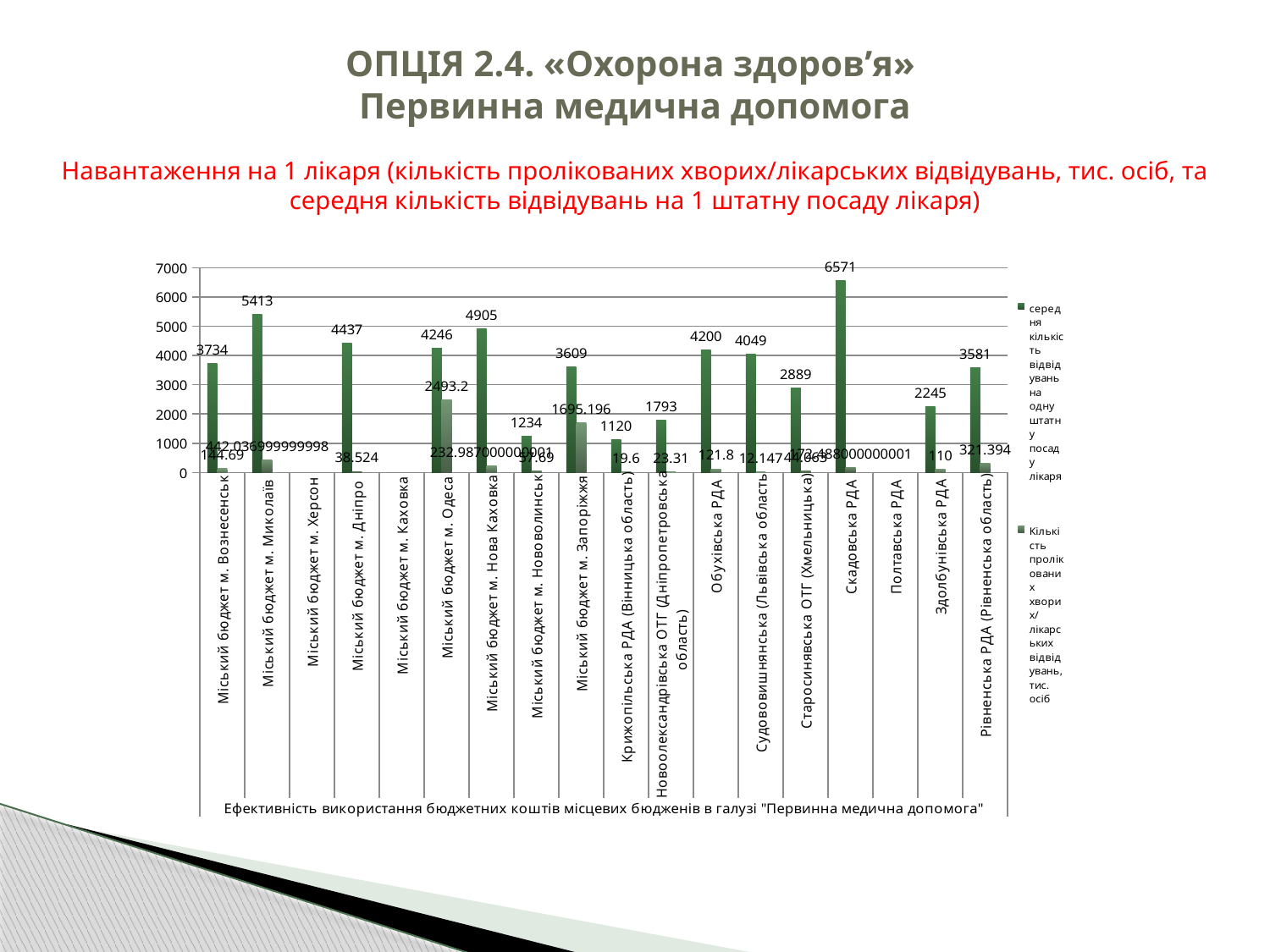
Which has a higher average number of visits per doctor position: Міський бюджет м. Дніпро or Міський бюджет м. Одеса? Міський бюджет м. Дніпро What type of chart is shown on the slide? Bar chart What is the difference between the average visits per doctor position for Міський бюджет м. Миколаїв and Міський бюджет м. Вознесенськ? 1679 What is the average number of visits per staff doctor position for Міський бюджет м. Нова Каховка? 4905 What is the average number of visits per staff doctor position for Здолбунівська РДА? 2245 Is the average number of visits per doctor position for Міський бюджет м. Запоріжжя greater or less than 3000? greater Which category has the highest average number of visits per staff doctor position? Скадовська РДА What is the average number of visits per staff doctor position for Міський бюджет м. Миколаїв? 5413 How many data series does the legend list? 2 What is the number of treated patients/doctor visits (thousand persons) for Міський бюджет м. Одеса? 2493.2 What is the average number of visits per staff doctor position (середня кількість відвідувань на одну штатну посаду лікаря) for Скадовська РДА? 6571 Among the categories with plotted bars, which has the lowest average number of visits per staff doctor position? Крижопільська РДА (Вінницька область)